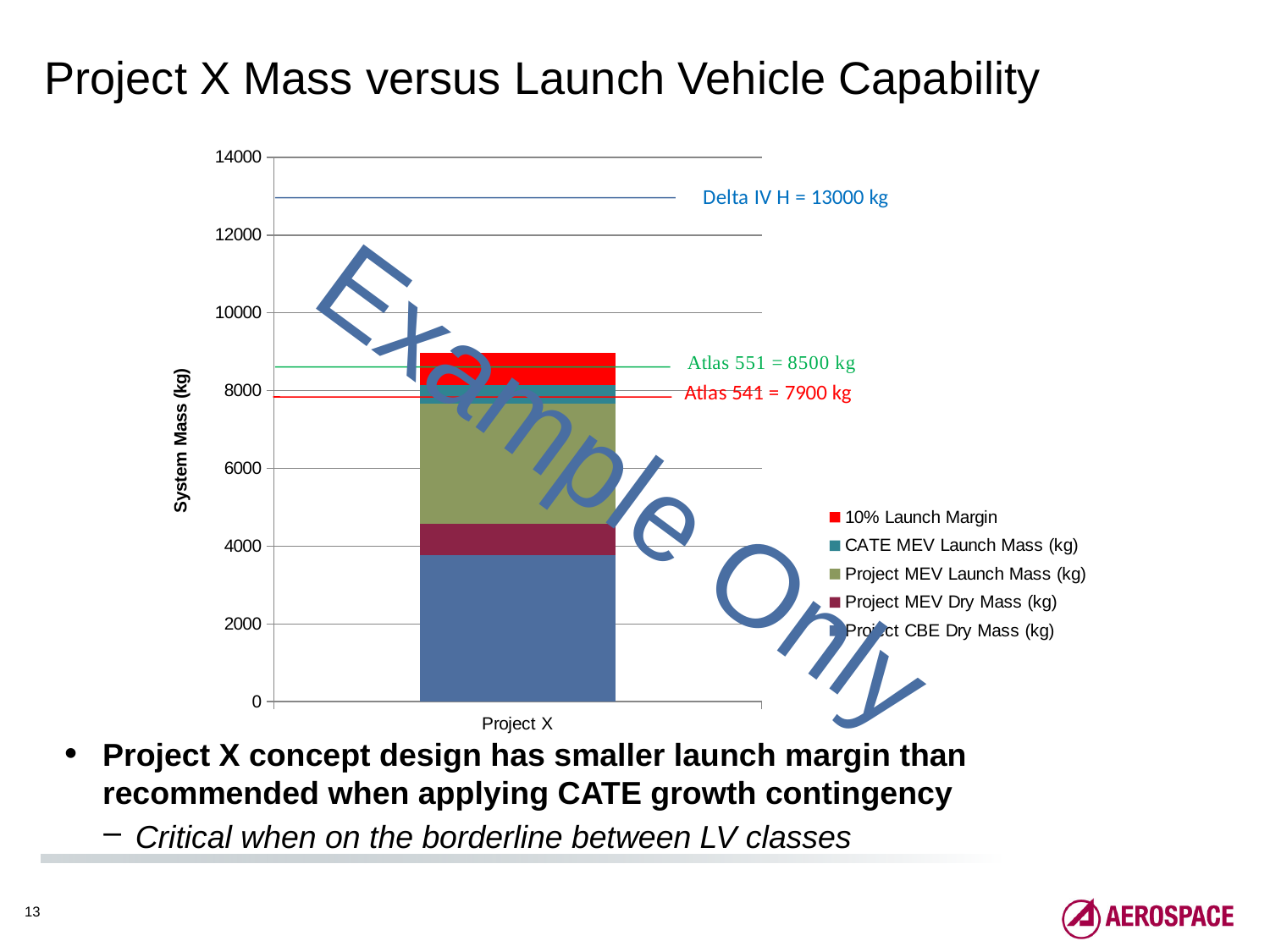
Is the total height of the Project X stacked bar greater or less than 8000? greater What kind of chart is shown on the slide? Stacked bar chart How many categories are plotted on the x axis? 1 What launch capability is shown for the Delta IV H reference line? 13000 kg How many series does the legend list? 5 What launch capability is shown for the Atlas 541 reference line? 7900 kg What is the label of the y axis? System Mass (kg) Is the Project CBE Dry Mass (kg) segment for Project X greater or less than 4000? less Is the total height of the Project X stacked bar greater or less than 10000? less What is the difference between the Atlas 551 and Atlas 541 capabilities? 600 kg What launch capability is shown for the Atlas 551 reference line? 8500 kg Which launch vehicle reference line has the highest capability? Delta IV H